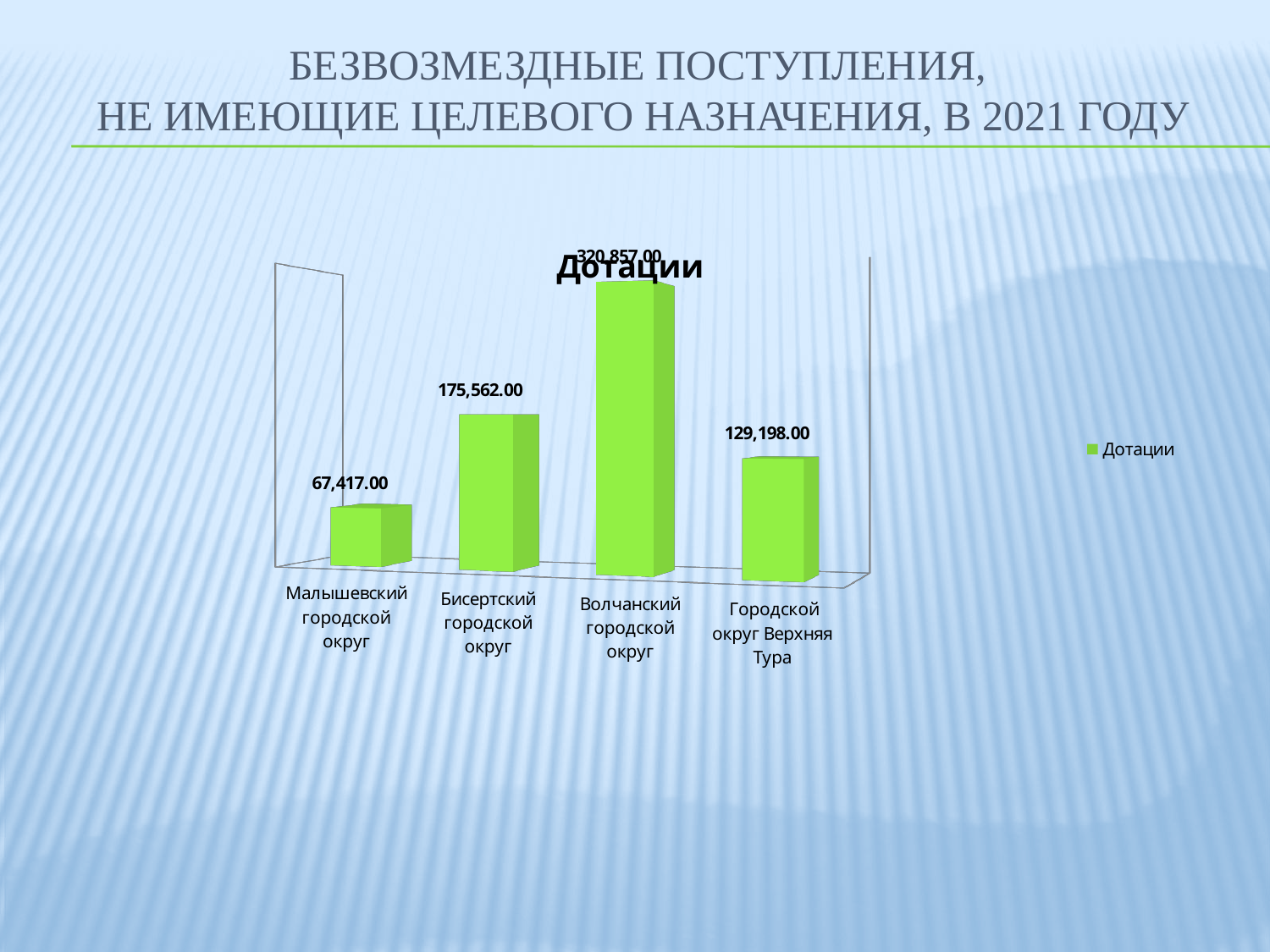
What is the value for Малышевский городской округ? 67,417.00 What is the difference between the values for Бисертский городской округ and Городской округ Верхняя Тура? 46,364.00 What is the title of the chart? Дотации What is the value for Бисертский городской округ? 175,562.00 What is the value for Волчанский городской округ? 320,857.00 What is the difference between the values for Бисертский городской округ and Малышевский городской округ? 108,145.00 Which category has the lowest value? Малышевский городской округ How many categories are shown in the chart? 4 Which category has the highest value? Волчанский городской округ Which is larger: the value for Бисертский городской округ or Городской округ Верхняя Тура? Бисертский городской округ What kind of chart is shown on the slide? Bar chart What is the value for Городской округ Верхняя Тура? 129,198.00